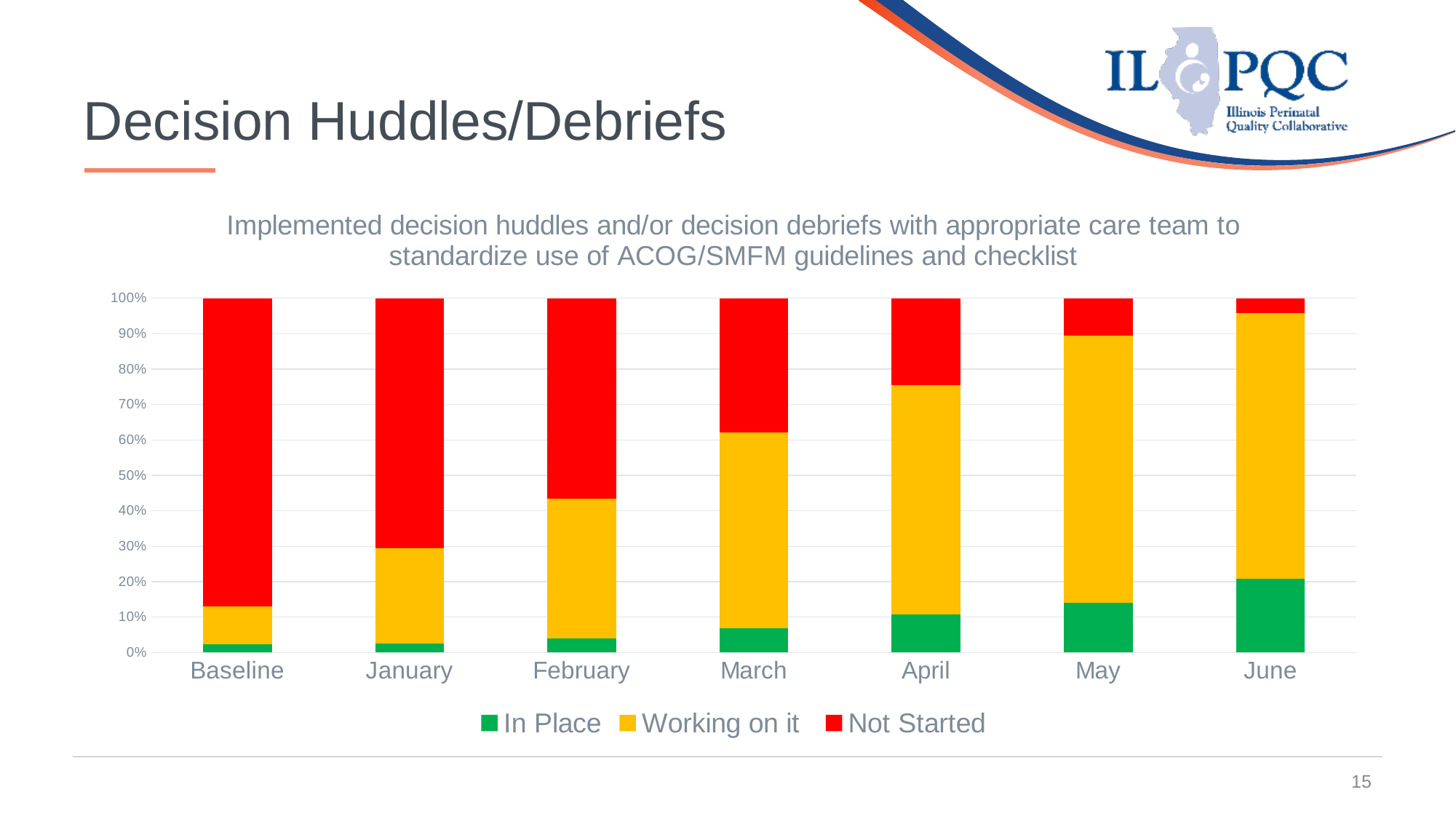
Which category has the smallest 'Not Started' segment? June Which is larger: the 'Not Started' segment for February or for April? February Is the 'Not Started' value for Baseline greater or less than 80%? greater Which category has the largest 'Not Started' segment? Baseline Does the 'Not Started' share rise or fall from Baseline to June? Fall Which colour represents 'Working on it' in the legend? Yellow Which category has the largest 'In Place' segment? June How many categories are shown along the x axis? 7 What kind of chart is shown on the slide? Stacked bar chart Does the 'In Place' share rise or fall from Baseline to June? Rise Is the 'In Place' value for May greater or less than 10%? greater How many series does the legend list? 3